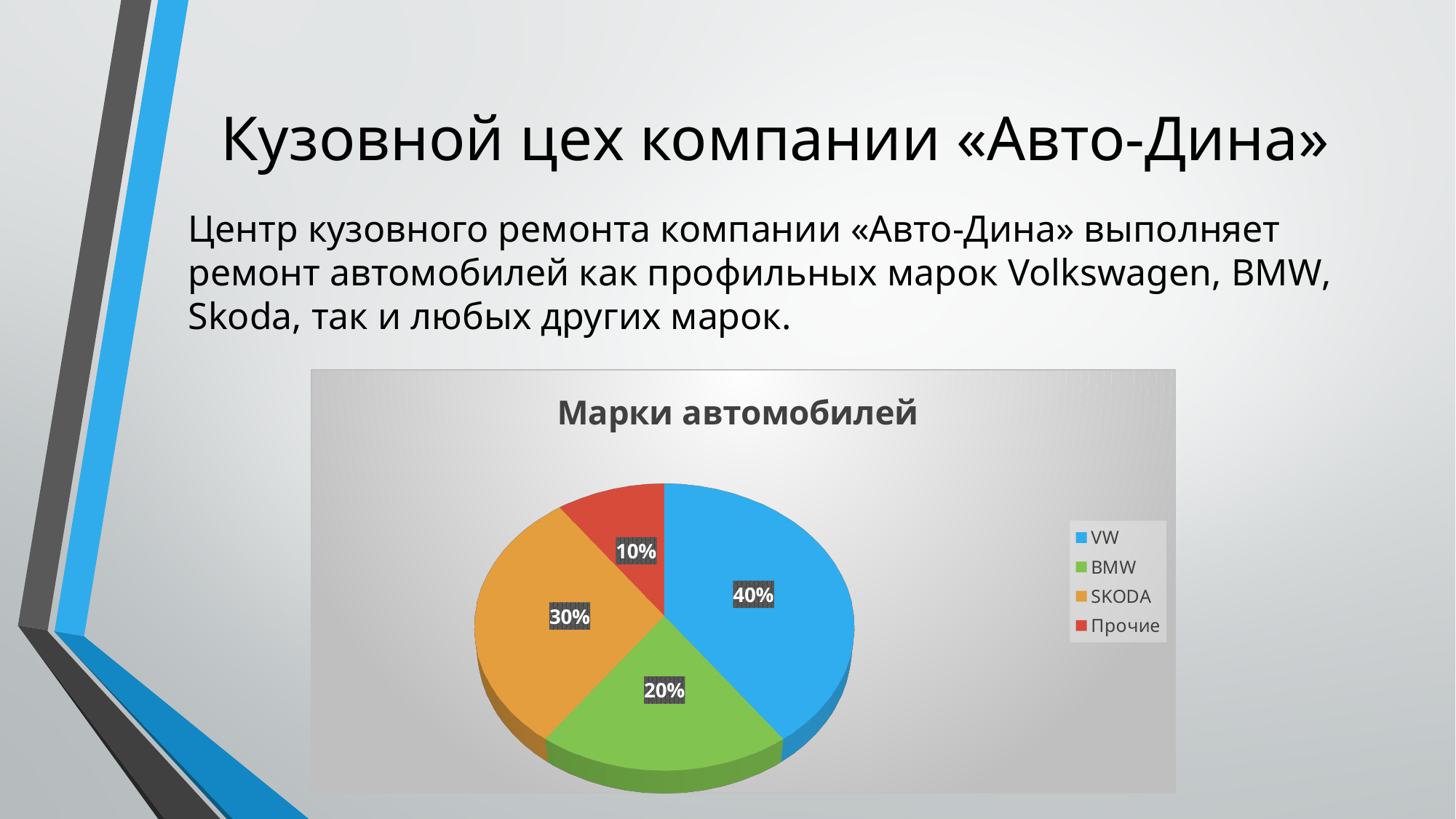
What share of the pie does BMW have? 20% What is the difference in percentage points between the VW and SKODA slices? 10 What is the title of the chart? Марки автомобилей What share of the pie does VW have? 40% Which category has the largest slice of the pie? VW What share of the pie does Прочие have? 10% Which slice is larger, BMW or SKODA? SKODA What share of the pie does SKODA have? 30% What kind of chart is shown on the slide? Pie chart Which category has the smallest slice of the pie? Прочие What colour is the SKODA slice in the pie chart? Orange How many categories does the pie chart show? 4